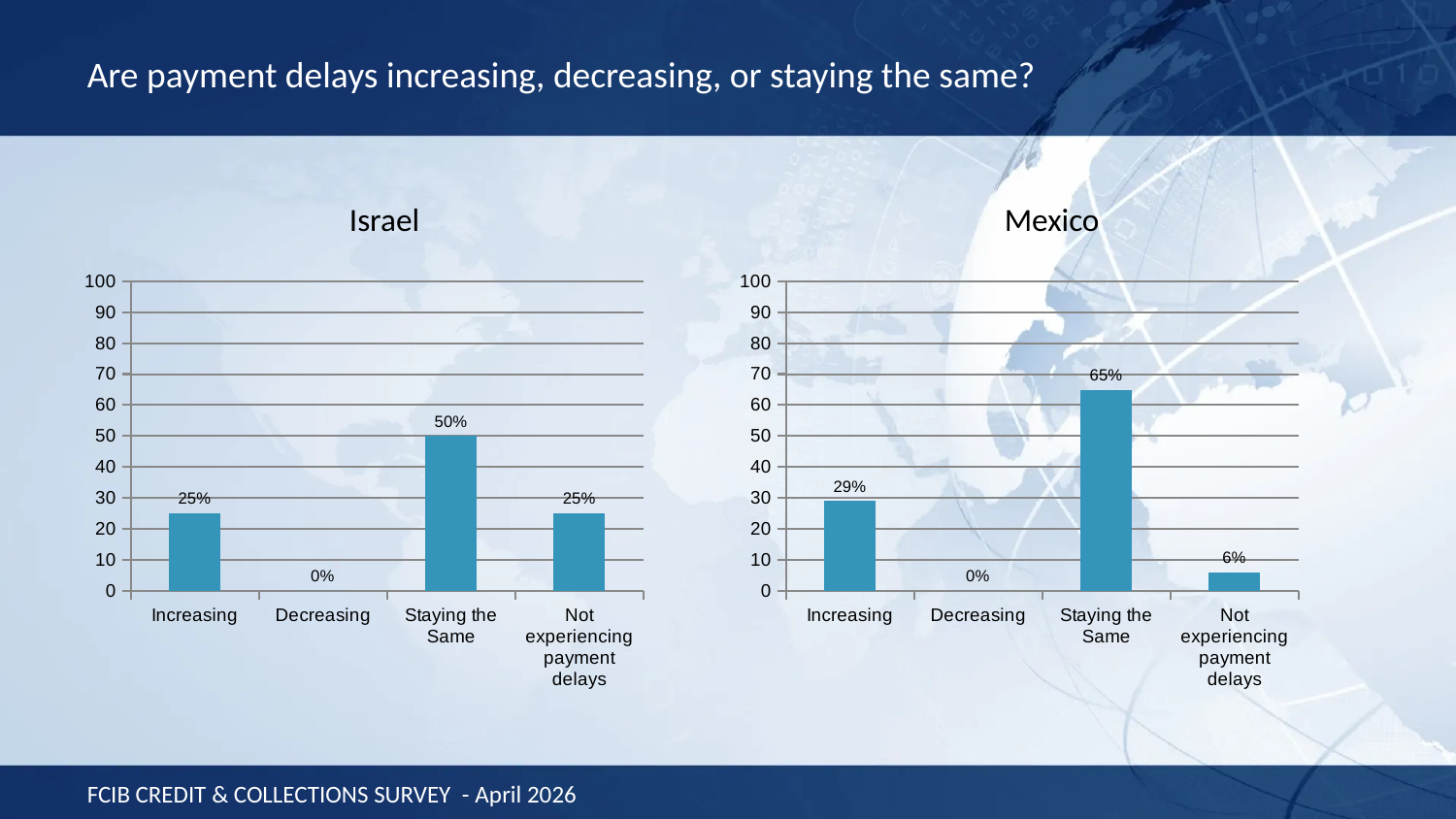
In the Mexico chart, which category has the lowest value? Decreasing In the Israel chart, what is the value for Staying the Same? 50% In the Mexico chart, what is the value for Not experiencing payment delays? 6% In the Israel chart, which category has the highest value? Staying the Same How many categories are shown in the Israel chart? 4 In the Israel chart, what is the difference between Staying the Same and Increasing? 25% In the Mexico chart, what is the difference between Staying the Same and Increasing? 36% What is the title of the chart on the left? Israel In the Mexico chart, what is the value for Increasing? 29% What kind of chart is the Mexico chart? bar chart In the Mexico chart, which is larger: Increasing or Not experiencing payment delays? Increasing In the Mexico chart, is the value for Staying the Same greater or less than 60? greater